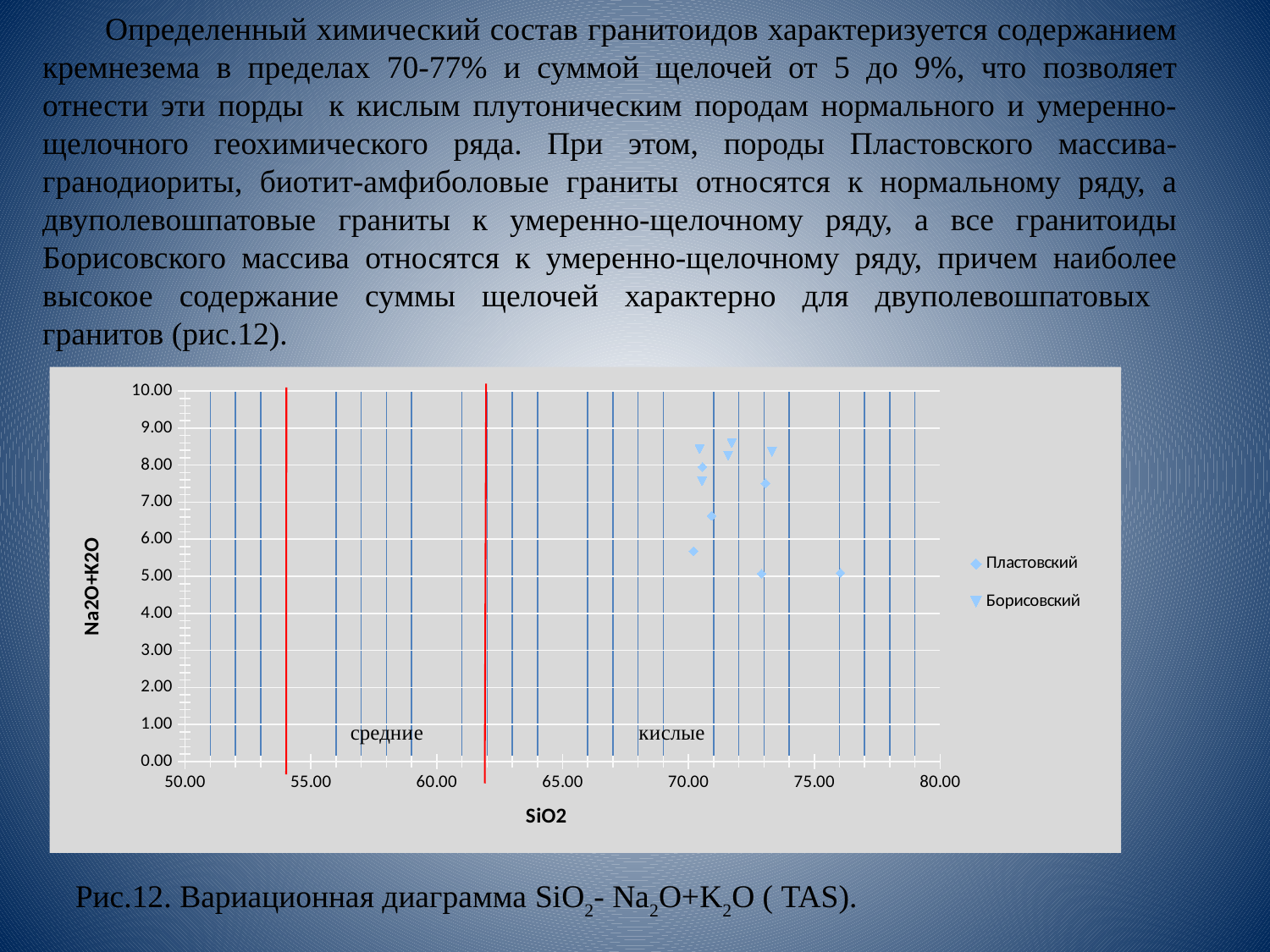
What are the two series named in the chart legend? Пластовский and Борисовский Is the highest Na2O+K2O value plotted on the chart greater or less than 9.00? less Is the lowest Na2O+K2O value for the Пластовский series greater or less than 6.00? less How many series does the chart legend list? 2 Is the highest SiO2 value plotted on the chart greater or less than 75.00? greater What is the title of the horizontal axis of the chart? SiO2 Which series contains the point with the highest SiO2 value? Пластовский Which series has the higher Na2O+K2O values overall, Пластовский or Борисовский? Борисовский What kind of chart is shown on the slide? scatter chart